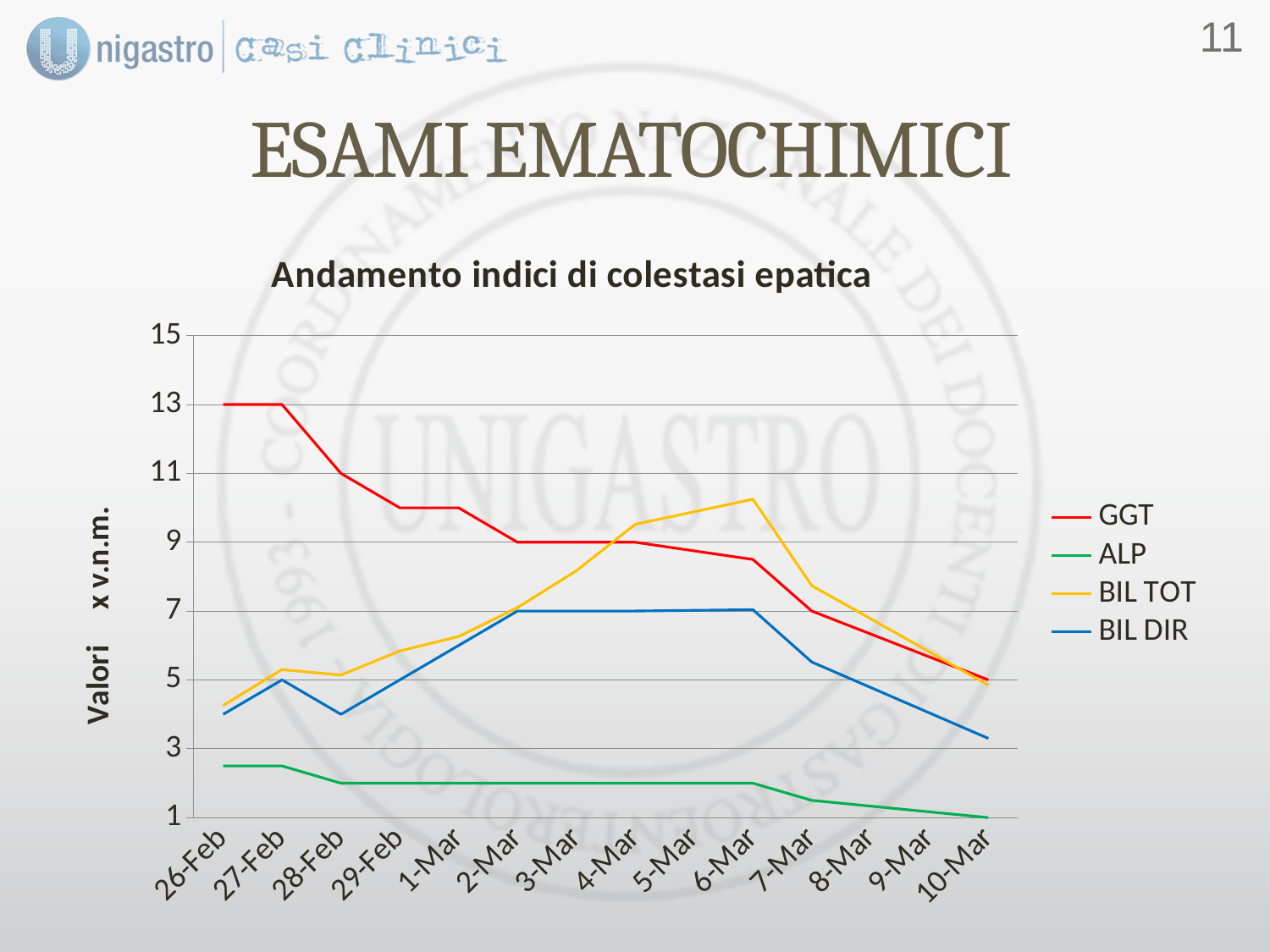
Is the GGT value on 28-Feb greater or less than 9? greater What is the GGT value on 26-Feb? 13 How many series does the legend list? 4 How many dates are shown along the x axis? 14 What is the ALP value on 10-Mar? 1 Does the GGT series generally rise or fall from 26-Feb to 10-Mar? fall What kind of chart is shown on the slide? line chart On 6-Mar, which is larger: BIL TOT or GGT? BIL TOT What is the BIL DIR value on 4-Mar? 7 Which series has the lowest value on 6-Mar? ALP What is the title of the chart? Andamento indici di colestasi epatica Which series has the highest value on 26-Feb? GGT